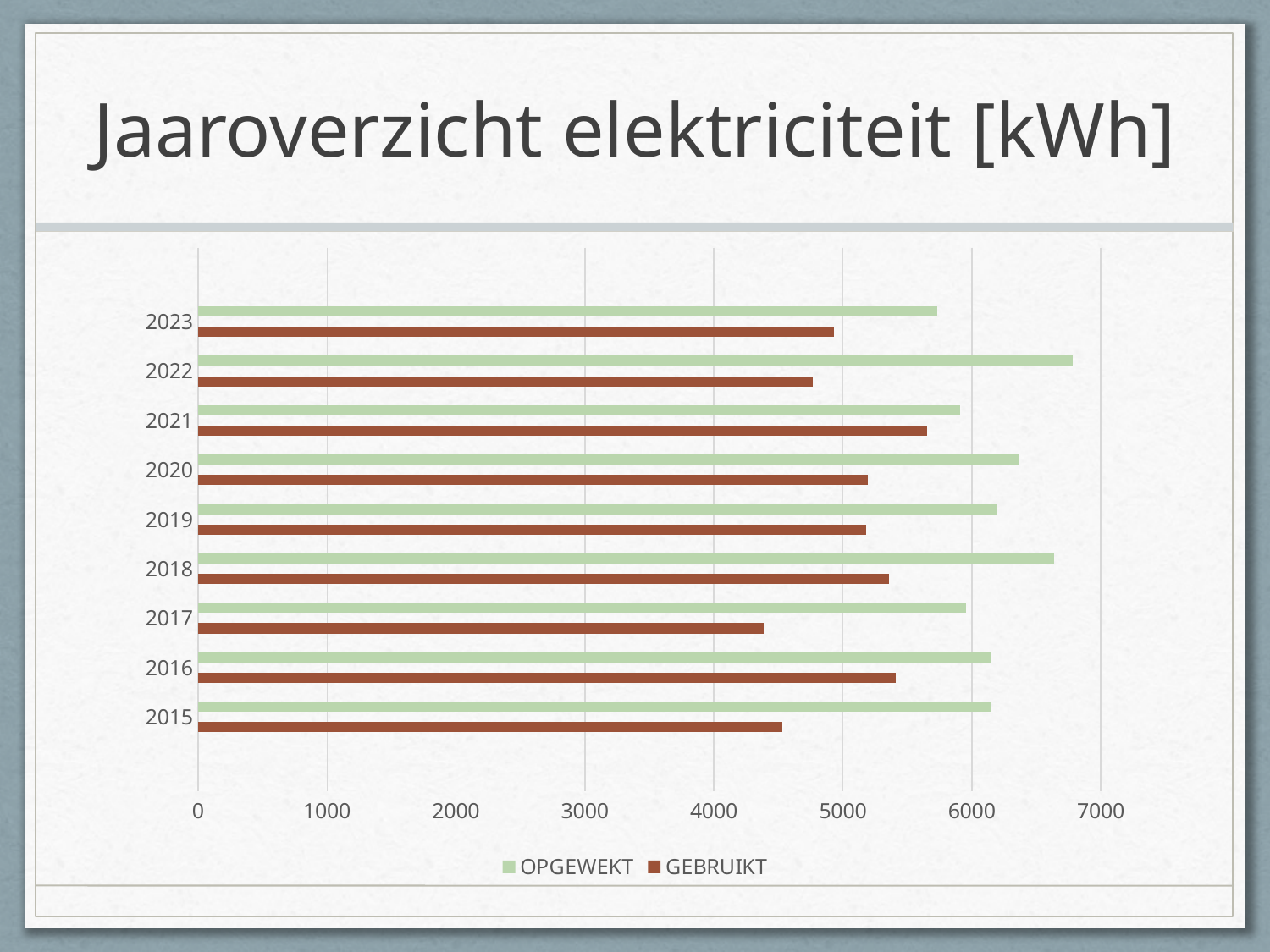
Which year has the highest OPGEWEKT value? 2022 What kind of chart is shown on the slide? bar chart Which year has the highest GEBRUIKT value? 2021 Is the OPGEWEKT value for 2022 greater or less than 6000? greater Which year has the lowest OPGEWEKT value? 2023 Is the GEBRUIKT value for 2017 greater or less than 5000? less How many series does the legend list? 2 How many years are shown on the chart? 9 For 2022, which is larger: OPGEWEKT or GEBRUIKT? OPGEWEKT Is the OPGEWEKT value for 2023 greater or less than 6000? less Which is larger: the GEBRUIKT value for 2021 or for 2017? 2021 What is the title of the chart on the slide? Jaaroverzicht elektriciteit [kWh]